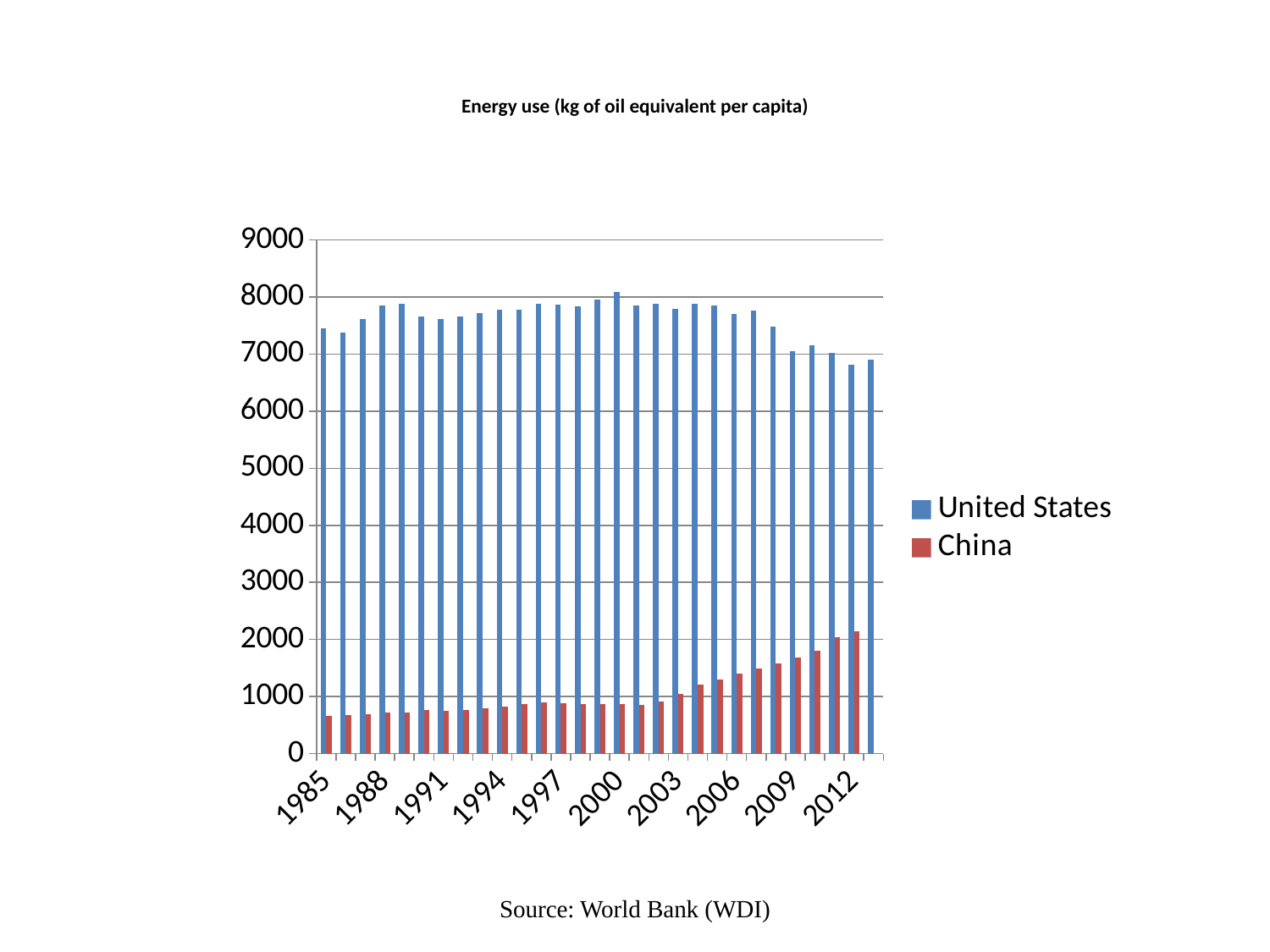
What kind of chart is shown on the slide? bar chart Is the value for China in 2009 greater or less than 2000? less Is the value for the United States in 1985 greater or less than 7000? greater Is the value for China in 1985 greater or less than 1000? less How many series does the legend list? 2 In 2012, which series has the larger value, United States or China? United States Which series is shown in red? China In which year does the United States series reach its highest value? 2000 What is the title of the chart? Energy use (kg of oil equivalent per capita) Do the values for China generally rise or fall from 1985 to 2012? rise